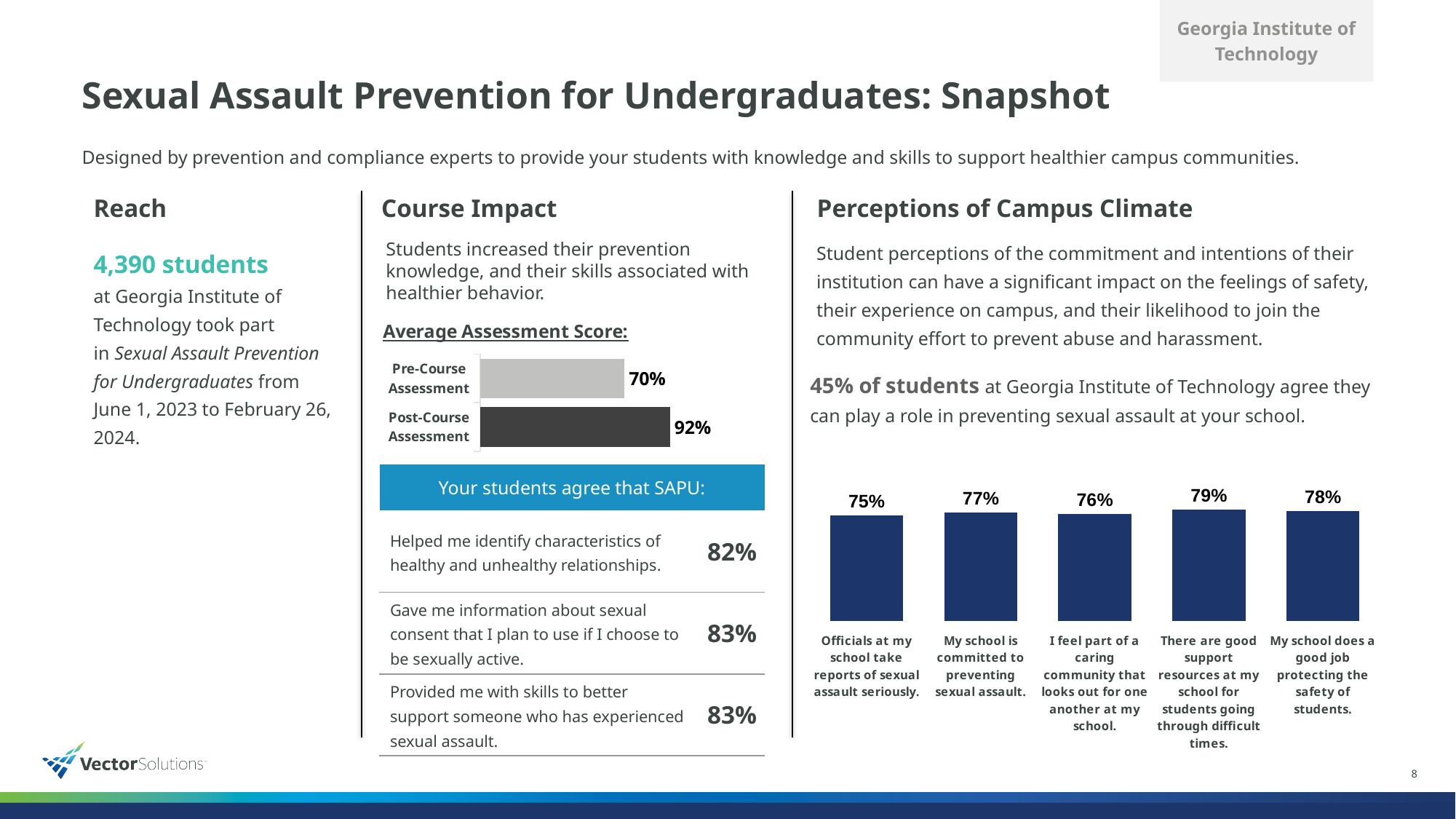
In the Perceptions of Campus Climate chart, what percentage of students agree there are good support resources at their school for students going through difficult times? 79% In the Average Assessment Score chart, what is the value for the Pre-Course Assessment? 70% In the Average Assessment Score chart, which assessment has the higher score, Pre-Course or Post-Course? Post-Course Assessment In the Perceptions of Campus Climate chart, what is the difference between the value for 'My school is committed to preventing sexual assault' and the value for 'I feel part of a caring community that looks out for one another at my school'? 1% In the Average Assessment Score chart, what is the difference between the Post-Course and Pre-Course Assessment scores? 22% What kind of chart is the Average Assessment Score chart? Bar chart In the Perceptions of Campus Climate chart, what percentage of students agree that officials at their school take reports of sexual assault seriously? 75% In the Average Assessment Score chart, what is the value for the Post-Course Assessment? 92% In the Perceptions of Campus Climate chart, what percentage of students agree that their school does a good job protecting the safety of students? 78% In the Perceptions of Campus Climate chart, which statement has the lowest percentage of agreement? Officials at my school take reports of sexual assault seriously. How many bars are shown in the Perceptions of Campus Climate chart? 5 In the Perceptions of Campus Climate chart, which statement has the highest percentage of agreement? There are good support resources at my school for students going through difficult times.